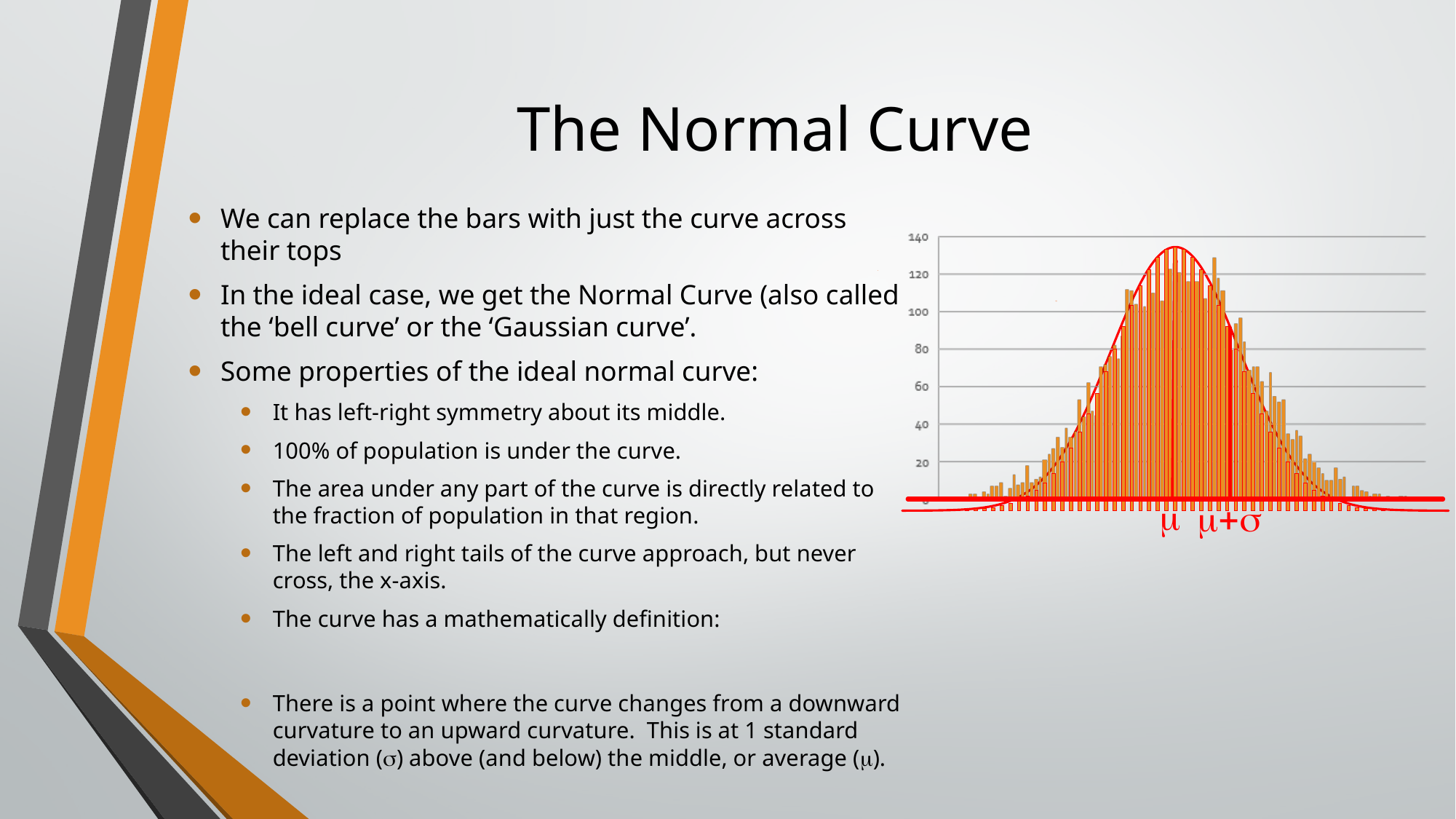
How many labelled tick values are shown on the vertical axis of the chart? 8 Do the bar heights rise or fall moving from μ toward the right edge of the chart? fall Is the value of the bar at μ greater or less than 100? greater Is the value of the tallest bar in the chart greater or less than 140? less What is the highest value labelled on the vertical axis of the chart? 140 Is the value of the tallest bar in the chart greater or less than 120? greater What kind of chart is shown on the right of the slide? bar chart Do the bar heights rise or fall moving from the left edge of the chart toward μ? rise What colour is the smooth curve drawn over the bars? red Which is larger, the bar at μ or the bar at μ+σ? μ